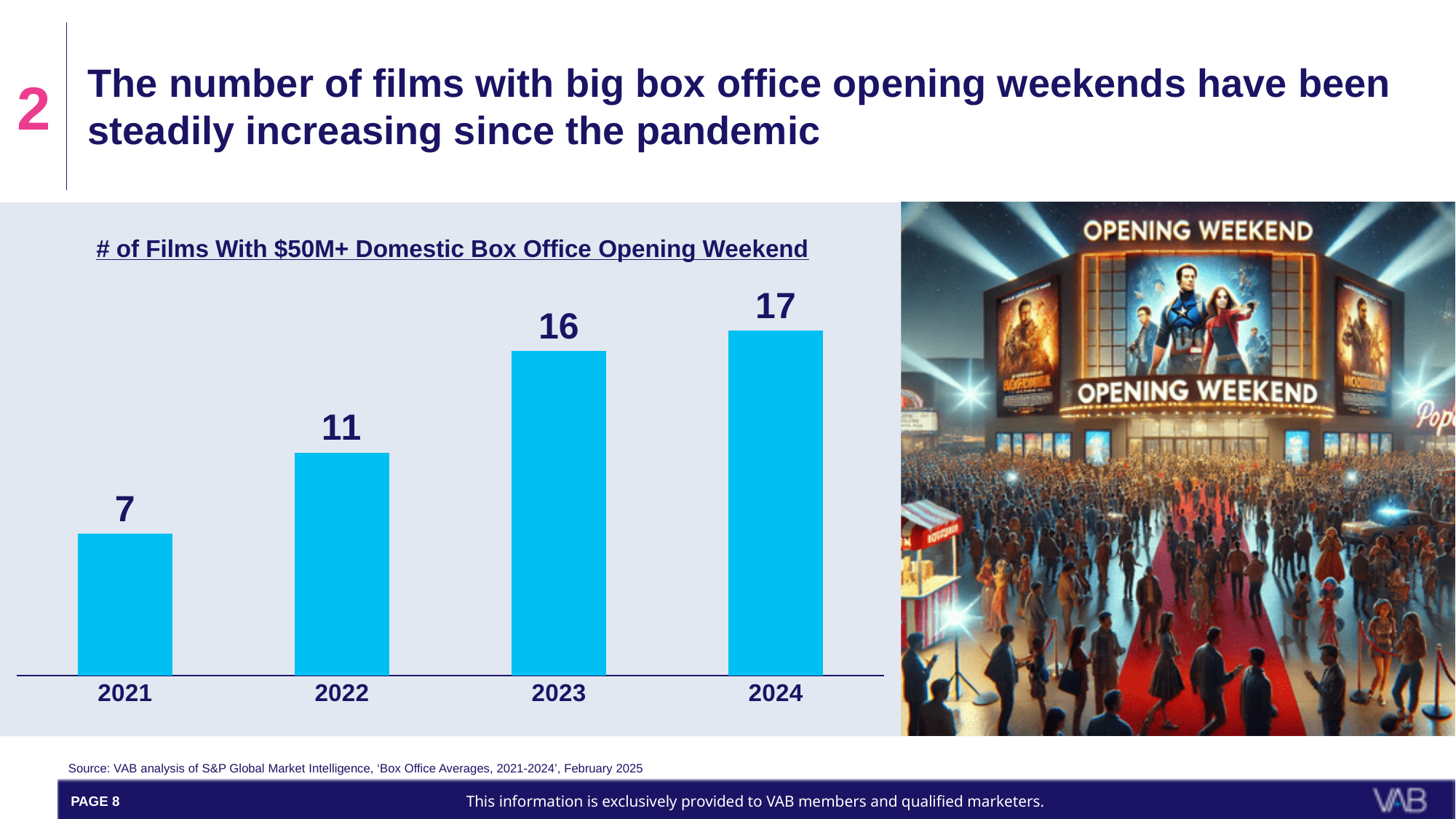
What is the value shown for 2022? 11 How many years are shown on the chart? 4 Which year has the lowest number of films with a $50M+ opening weekend? 2021 By how much did the number of films increase from 2022 to 2023? 5 Which year has the larger value, 2022 or 2023? 2023 What is the difference between the 2024 value and the 2021 value? 10 What is the value shown for 2023? 16 Do the values rise or fall from 2021 to 2024? Rise How many films had a $50M+ domestic box office opening weekend in 2021? 7 Which year has the highest number of films with a $50M+ opening weekend? 2024 What type of chart is shown on the slide? Bar chart What is the value shown for 2024? 17